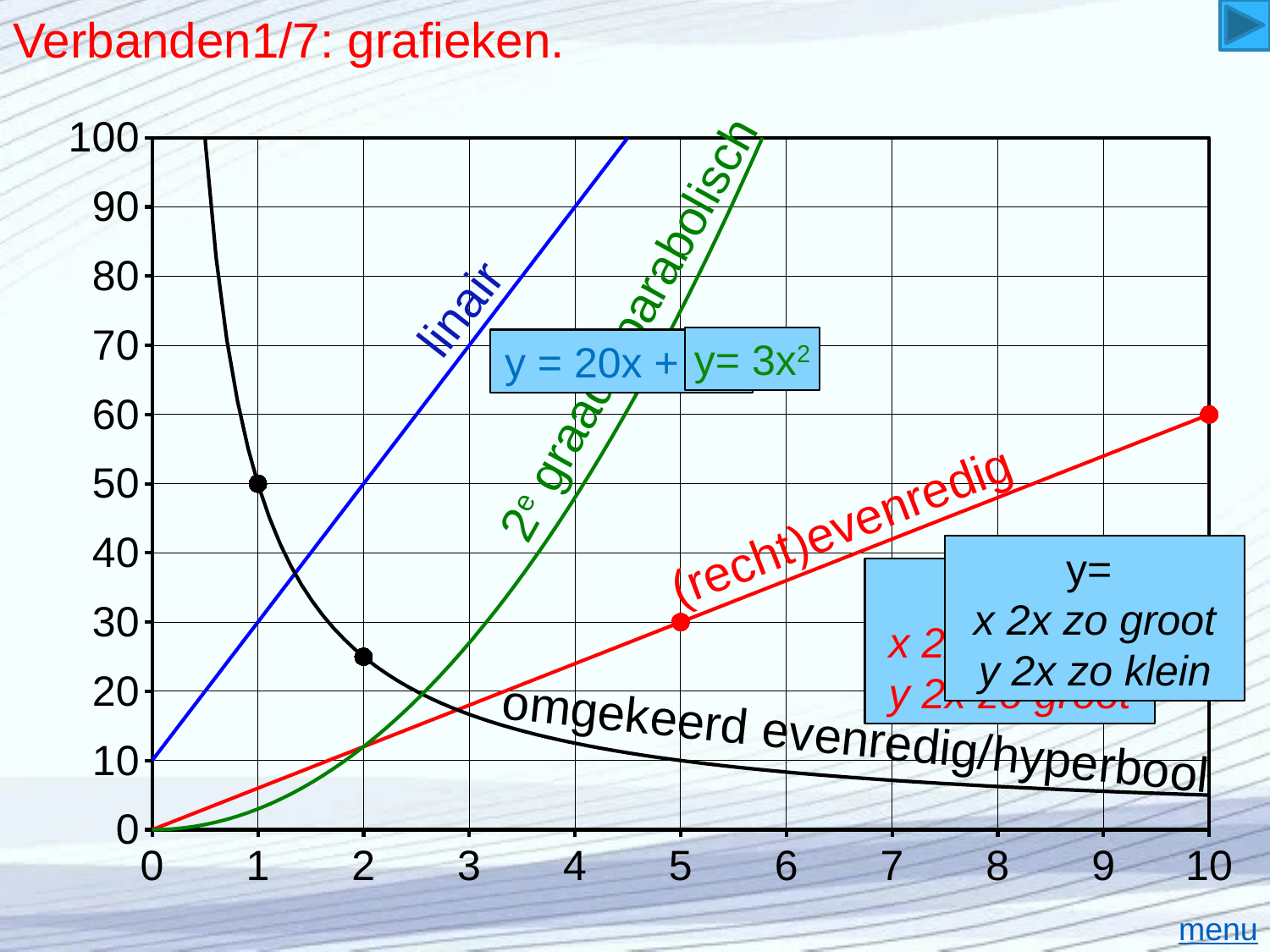
By how much does the red line's y value increase between the marked points at x = 5 and x = 10? 30 What is the y value of the marked point on the black hyperbool curve at x = 1? 50 Does the black omgekeerd evenredig/hyperbool curve rise or fall as x increases? fall Which formula is shown in the green box for the parabolic curve? y= 3x² At x = 2, which curve has the larger y value: the black hyperbool curve or the red (recht)evenredig line? black hyperbool curve Is the y value of the blue linair line at x = 3 greater or less than 60? greater What is the highest value shown on the y axis? 100 What is the y value of the marked point on the red (recht)evenredig line at x = 10? 60 How many curves are plotted on the chart? 4 What is the y value of the marked point on the red (recht)evenredig line at x = 5? 30 What kind of chart is shown on the slide? line chart